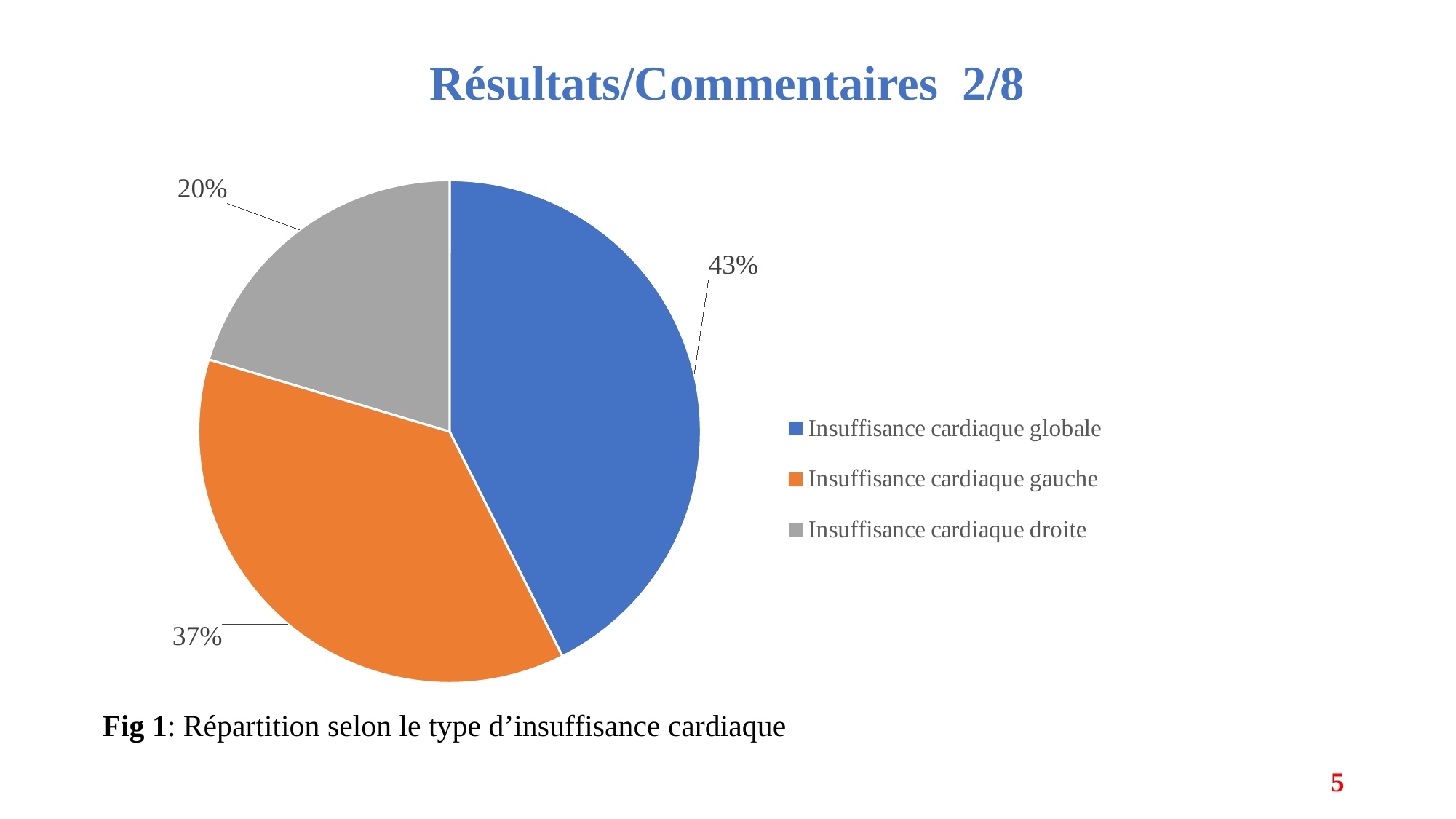
What colour is the slice for Insuffisance cardiaque droite? Grey Which is larger: the slice for Insuffisance cardiaque gauche or the slice for Insuffisance cardiaque droite? Insuffisance cardiaque gauche How many categories are shown in the pie chart? 3 What share of the pie does Insuffisance cardiaque gauche represent? 37% Which category has the smallest slice of the pie? Insuffisance cardiaque droite What is the caption of the figure shown on the slide? Fig 1: Répartition selon le type d'insuffisance cardiaque What is the difference in percentage points between Insuffisance cardiaque gauche and Insuffisance cardiaque droite? 17 What share of the pie does Insuffisance cardiaque droite represent? 20% Which category has the largest slice of the pie? Insuffisance cardiaque globale What is the difference in percentage points between Insuffisance cardiaque globale and Insuffisance cardiaque gauche? 6 What kind of chart is shown on the slide? Pie chart What share of the pie does Insuffisance cardiaque globale represent? 43%